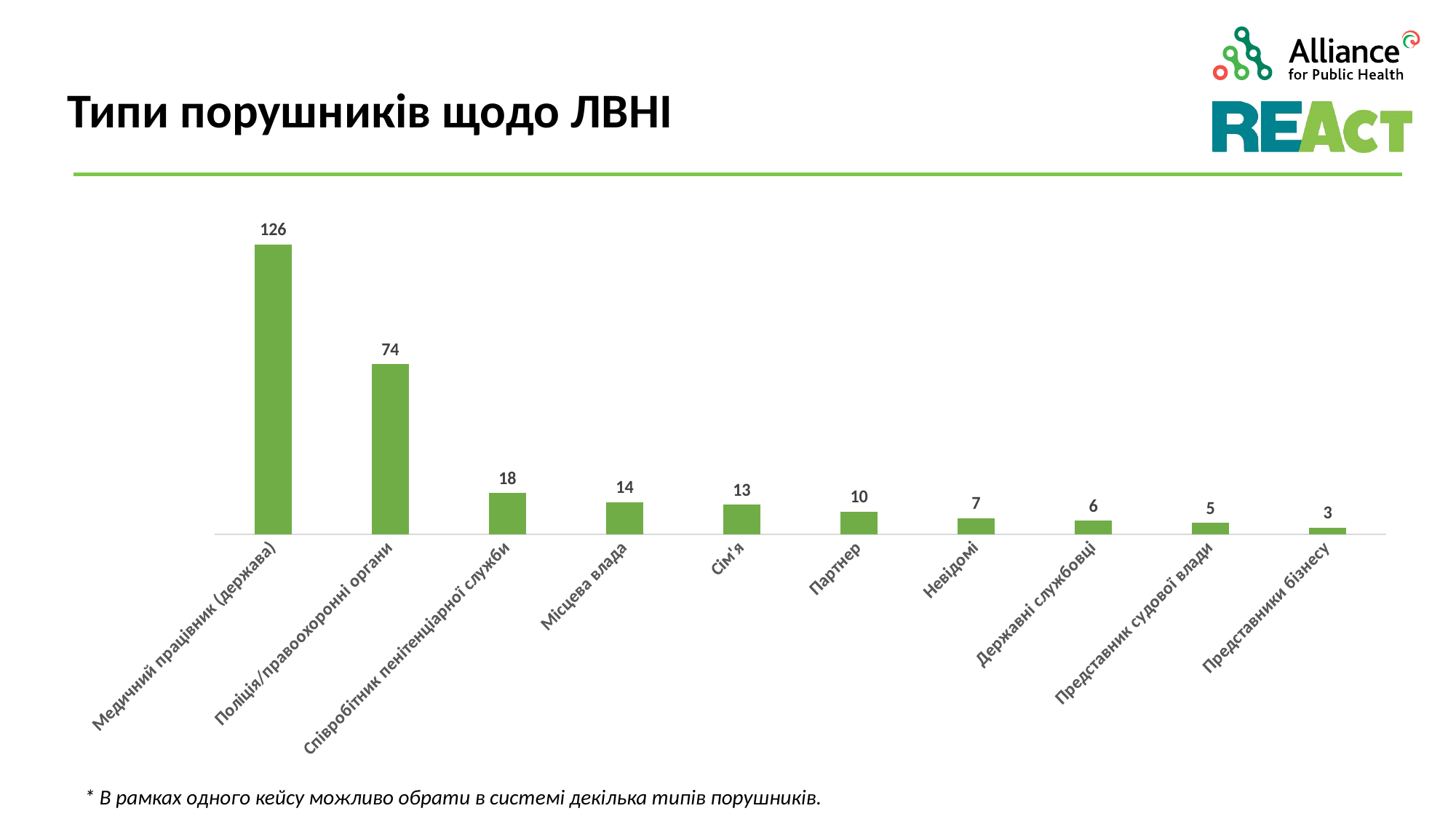
What kind of chart is shown on the slide? Bar chart What is the value for Представник судової влади? 5 What is the value for Поліція/правоохоронні органи? 74 What is the value for Медичний працівник (держава)? 126 Which category has the lowest value? Представники бізнесу Which category has the highest value? Медичний працівник (держава) What is the title of the slide? Типи порушників щодо ЛВНІ What is the difference between the values for Медичний працівник (держава) and Поліція/правоохоронні органи? 52 Which is larger, the value for Місцева влада or the value for Партнер? Місцева влада How many categories are shown in the chart? 10 What is the value for Співробітник пенітенціарної служби? 18 What is the value for Сім'я? 13